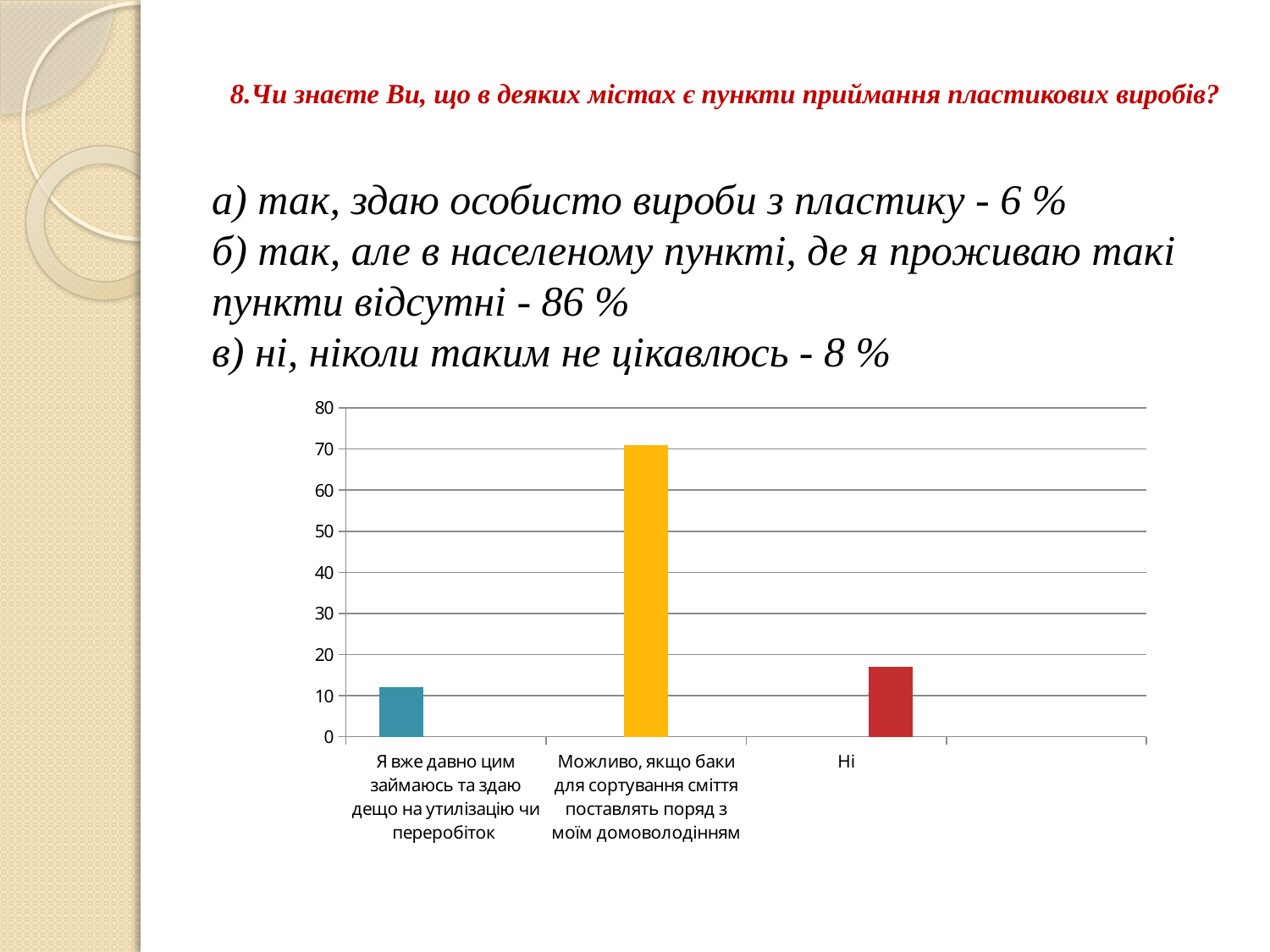
What kind of chart is shown on the slide? bar chart What is the highest value shown on the vertical axis of the chart? 80 How many bars does the chart show? 3 Is the value for "Ні" greater or less than 20? less Is the value for "Можливо, якщо баки для сортування сміття поставлять поряд з моїм домоволодінням" greater or less than 60? greater Is the value for "Можливо, якщо баки для сортування сміття поставлять поряд з моїм домоволодінням" greater or less than 80? less Which is larger: the value for "Ні" or the value for "Я вже давно цим займаюсь та здаю дещо на утилізацію чи переробіток"? Ні What colour is the bar for "Ні"? red Which category has the lowest bar in the chart? Я вже давно цим займаюсь та здаю дещо на утилізацію чи переробіток Which category has the highest bar in the chart? Можливо, якщо баки для сортування сміття поставлять поряд з моїм домоволодінням